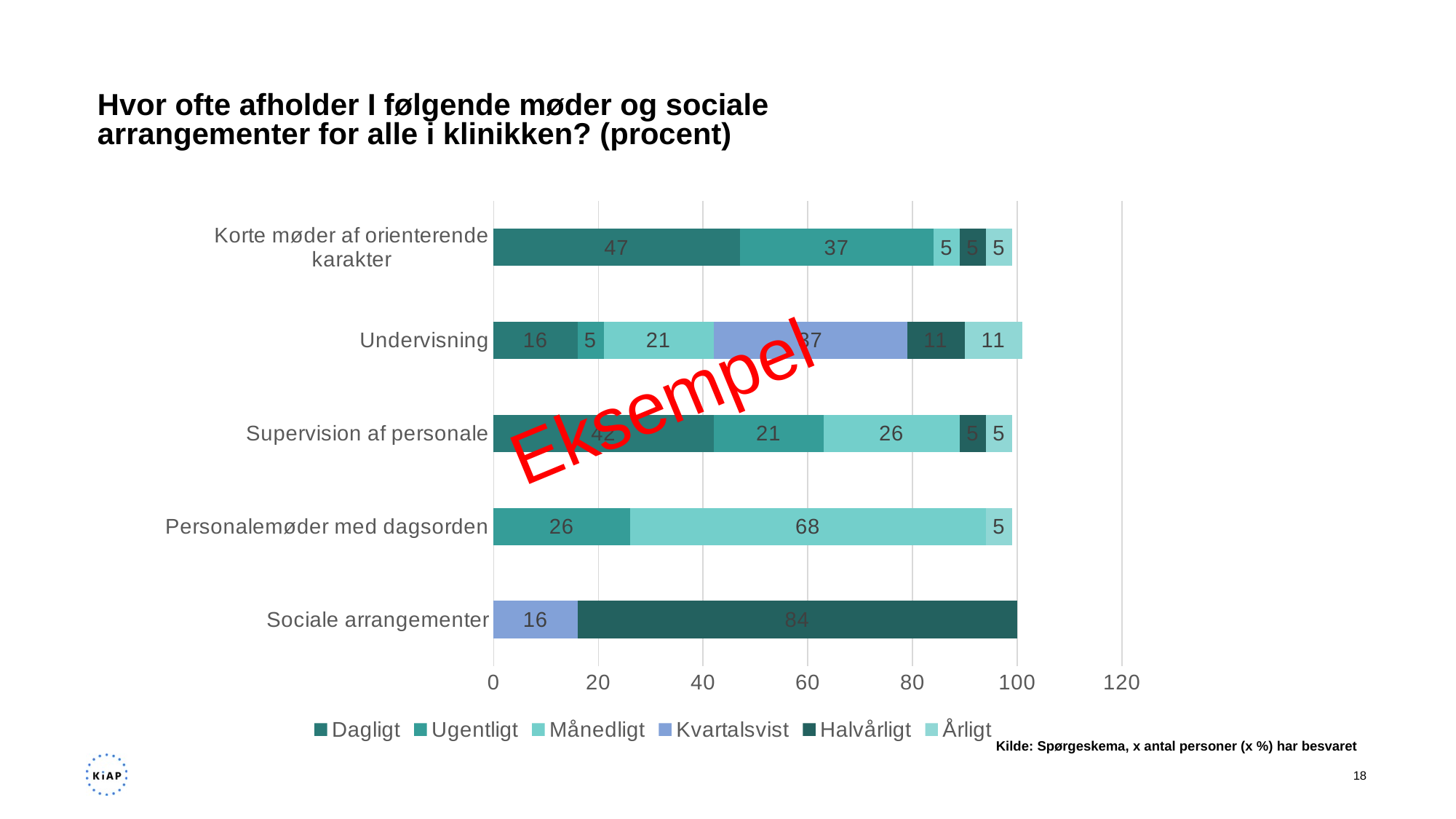
What is the difference between the Dagligt and Ugentligt values for Korte møder af orienterende karakter? 10 What is the Månedligt value for Personalemøder med dagsorden? 68 Which series is listed first in the legend? Dagligt Which category has the largest Halvårligt value? Sociale arrangementer What is the Månedligt value for Undervisning? 21 What is the total of the stacked bar for Personalemøder med dagsorden? 99 How many series does the legend list? 6 Which has the larger Ugentligt value: Korte møder af orienterende karakter or Personalemøder med dagsorden? Korte møder af orienterende karakter What is the Halvårligt value for Sociale arrangementer? 84 How many categories (meeting types) are shown on the chart? 5 What kind of chart is shown on the slide? bar chart What is the Dagligt value for Korte møder af orienterende karakter? 47